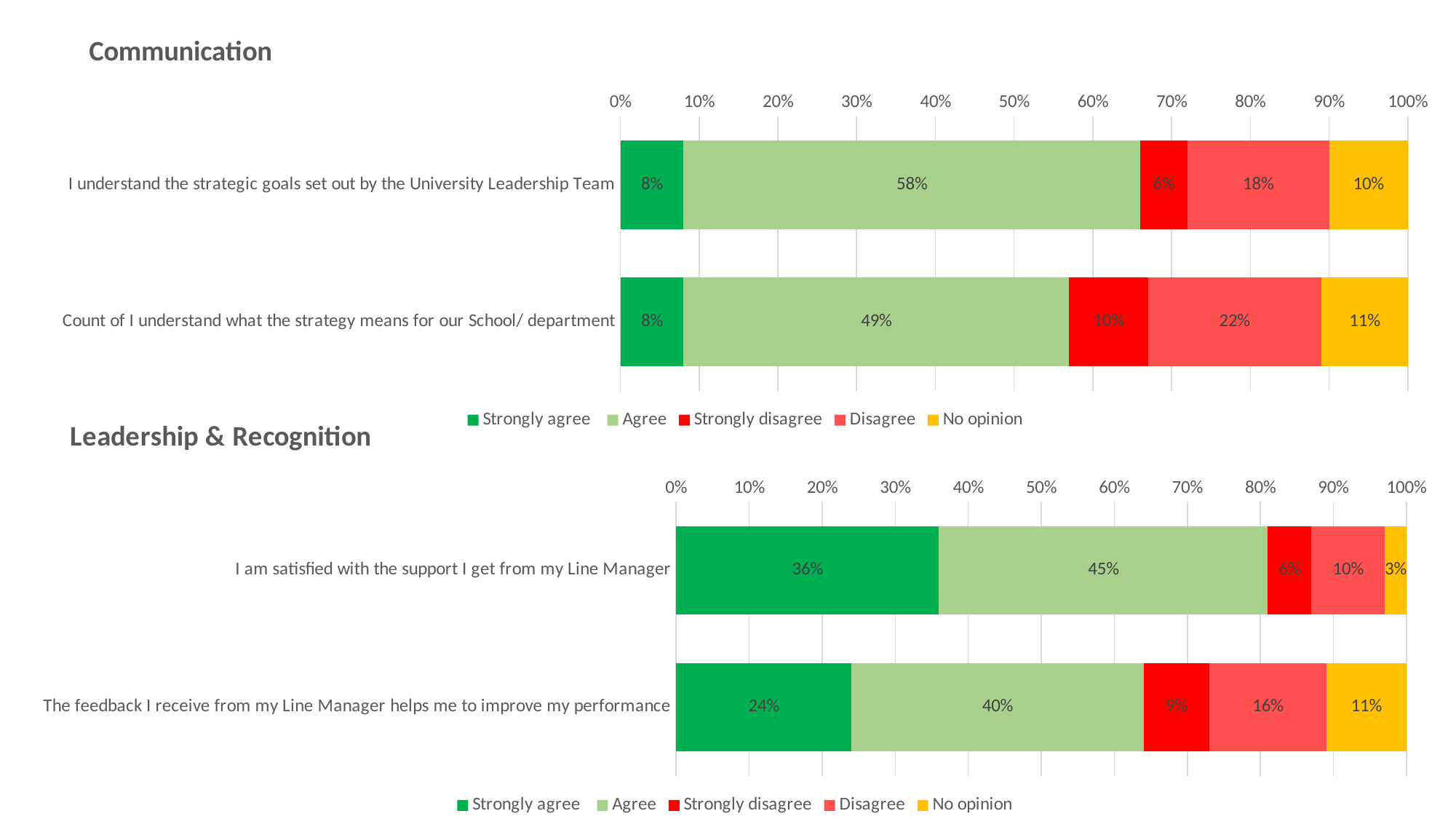
In the Leadership & Recognition chart, what is the 'No opinion' value for 'The feedback I receive from my Line Manager helps me to improve my performance'? 11% In the Leadership & Recognition chart, which statement has the higher 'Strongly agree' value? I am satisfied with the support I get from my Line Manager In the Communication chart, what percentage of respondents agree that they understand the strategic goals set out by the University Leadership Team? 58% In the Communication chart, what is the 'Disagree' value for 'Count of I understand what the strategy means for our School/ department'? 22% In the Leadership & Recognition chart, what is the difference between the 'Agree' values for the two statements? 5% In the Communication chart, which statement has the larger 'Strongly disagree' value? Count of I understand what the strategy means for our School/ department How many statements (categories) are plotted in the Leadership & Recognition chart? 2 How many series does the legend of the Communication chart list? 5 In the Communication chart, what is the combined 'Strongly agree' and 'Agree' total for 'I understand the strategic goals set out by the University Leadership Team'? 66% In the Leadership & Recognition chart, what is the 'Strongly agree' value for 'I am satisfied with the support I get from my Line Manager'? 36% What type of chart is the Communication chart? Stacked bar chart In the Leadership & Recognition chart, which colour represents 'No opinion'? Yellow